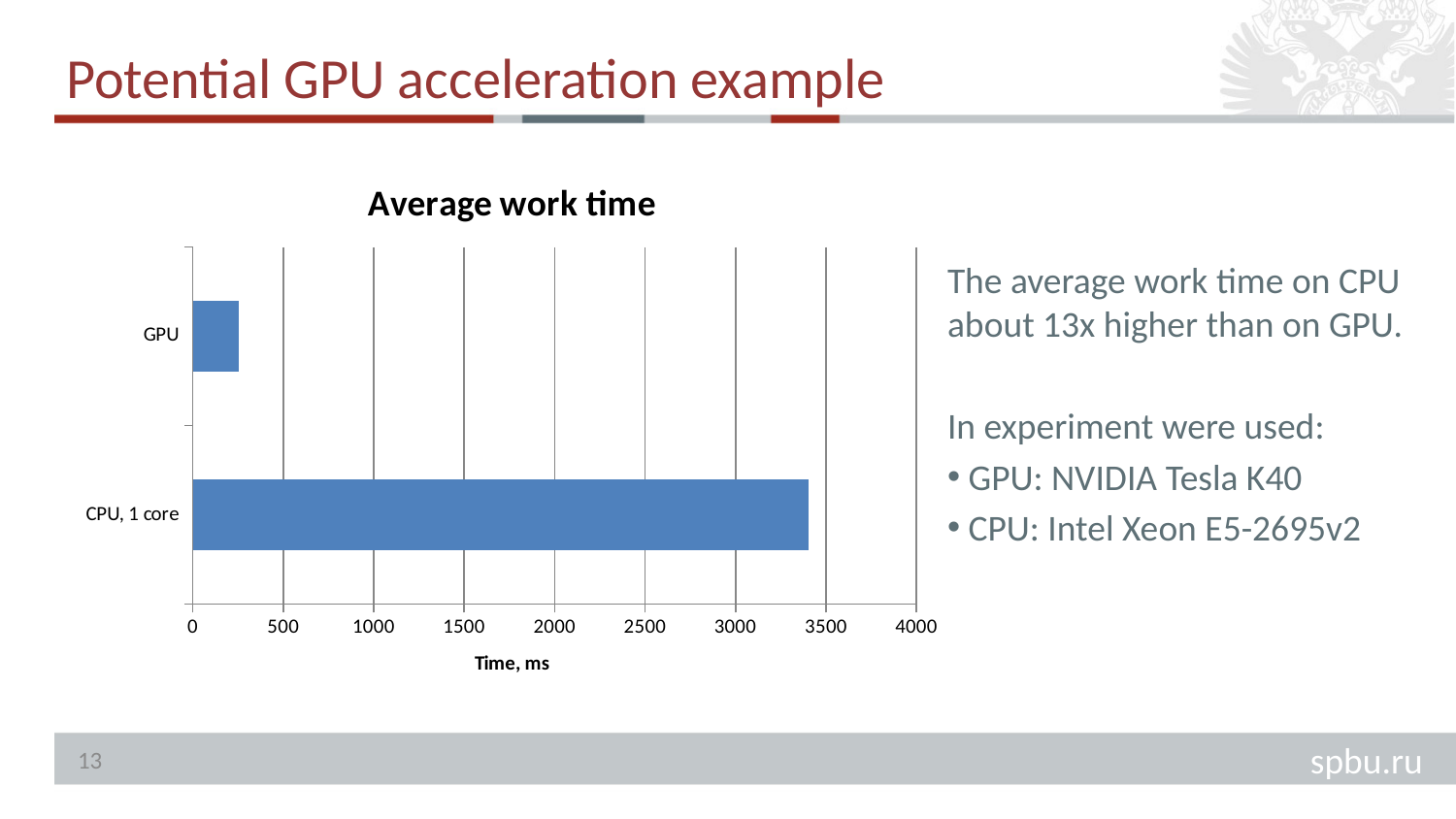
Which category has the highest average work time? CPU, 1 core What is the maximum value shown on the horizontal axis? 4000 What is the label of the horizontal axis? Time, ms Is the value for CPU, 1 core greater or less than 3000? greater Is the value for CPU, 1 core greater or less than 3500? less Is the value for GPU greater or less than 500? less What is the title of the chart? Average work time Which category has the lowest average work time? GPU Which is larger, the value for GPU or the value for CPU, 1 core? CPU, 1 core What type of chart is shown on the slide? bar chart How many categories are plotted in the chart? 2